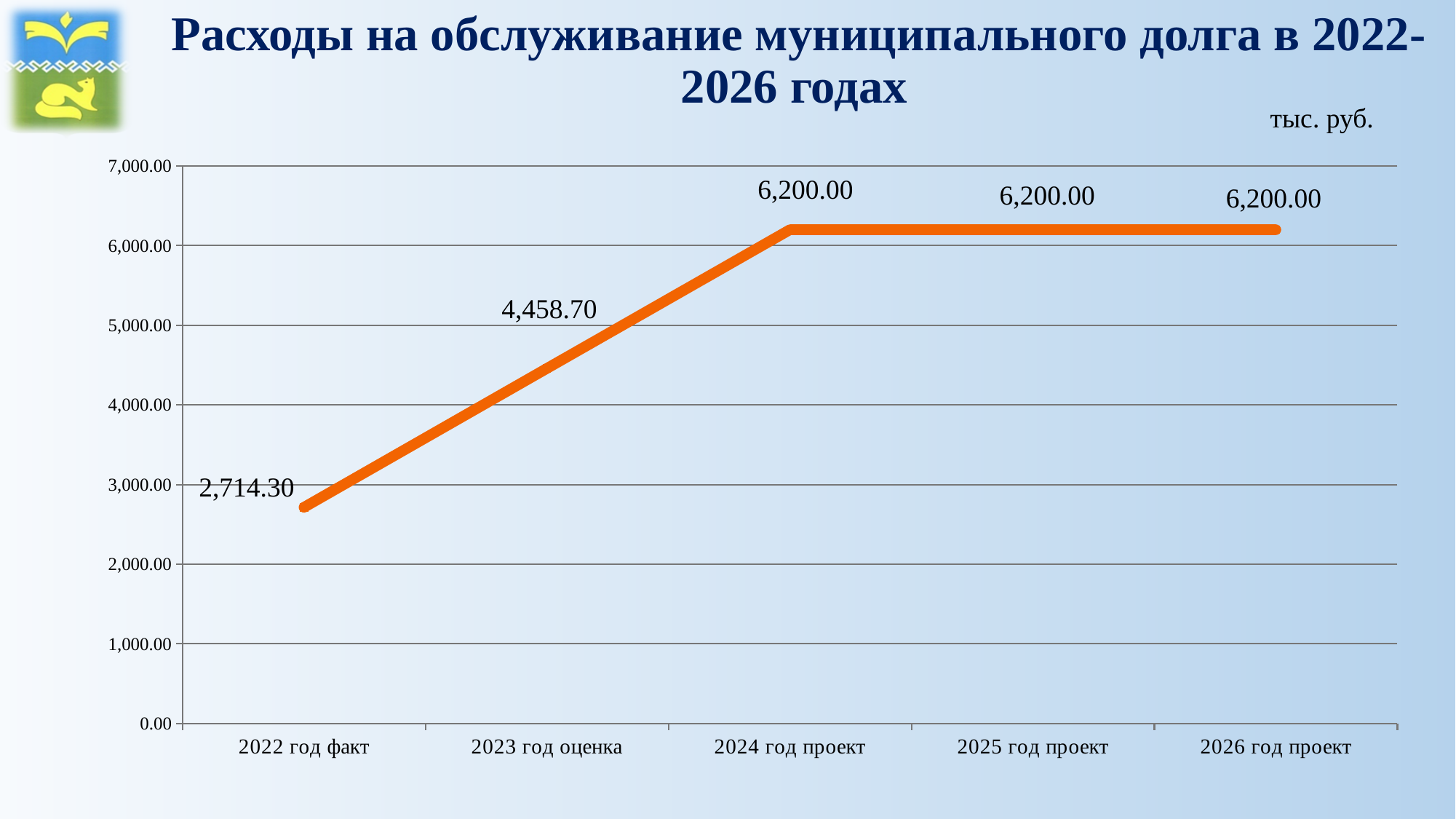
Which is larger, the value for 2023 год оценка or the value for 2022 год факт? 2023 год оценка What is the value for 2022 год факт? 2,714.30 What kind of chart is shown on the slide? line chart Which category has the lowest value? 2022 год факт Is the value for 2023 год оценка greater or less than 4,000.00? greater Do the values rise or fall from 2022 год факт to 2024 год проект? rise What is the difference between the values for 2024 год проект and 2023 год оценка? 1,741.30 What is the value for 2024 год проект? 6,200.00 What is the value for 2023 год оценка? 4,458.70 What is the value for 2026 год проект? 6,200.00 What is the difference between the values for 2023 год оценка and 2022 год факт? 1,744.40 How many categories are shown on the x axis? 5